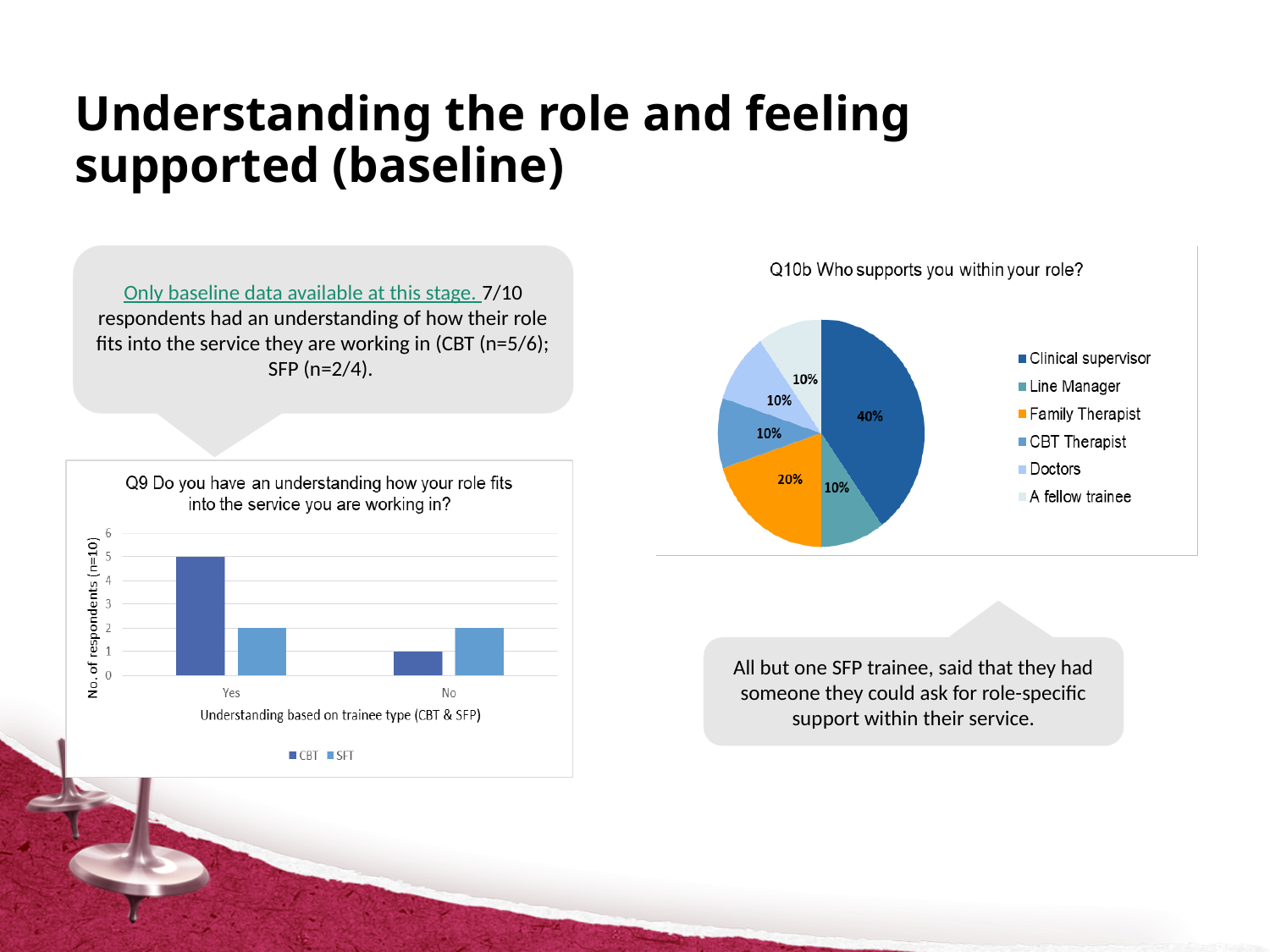
In the Q10b pie chart, what share is Family Therapist? 20% In the Q9 chart, how many SFT respondents answered No? 2 In the Q10b pie chart, which category has the largest slice? Clinical supervisor In the Q9 chart, how many CBT respondents answered Yes? 5 In the Q9 chart, which series has the larger value for No, CBT or SFT? SFT What is the title of the pie chart on the right? Q10b Who supports you within your role? In the Q9 chart, what is the difference between the CBT and SFT values for Yes? 3 In the Q10b pie chart, what share is Clinical supervisor? 40% In the Q9 chart, how many CBT respondents answered No? 1 What kind of chart is the Q9 chart? Bar chart In the Q9 chart, how many series does the legend list? 2 How many categories does the Q10b pie chart legend list? 6